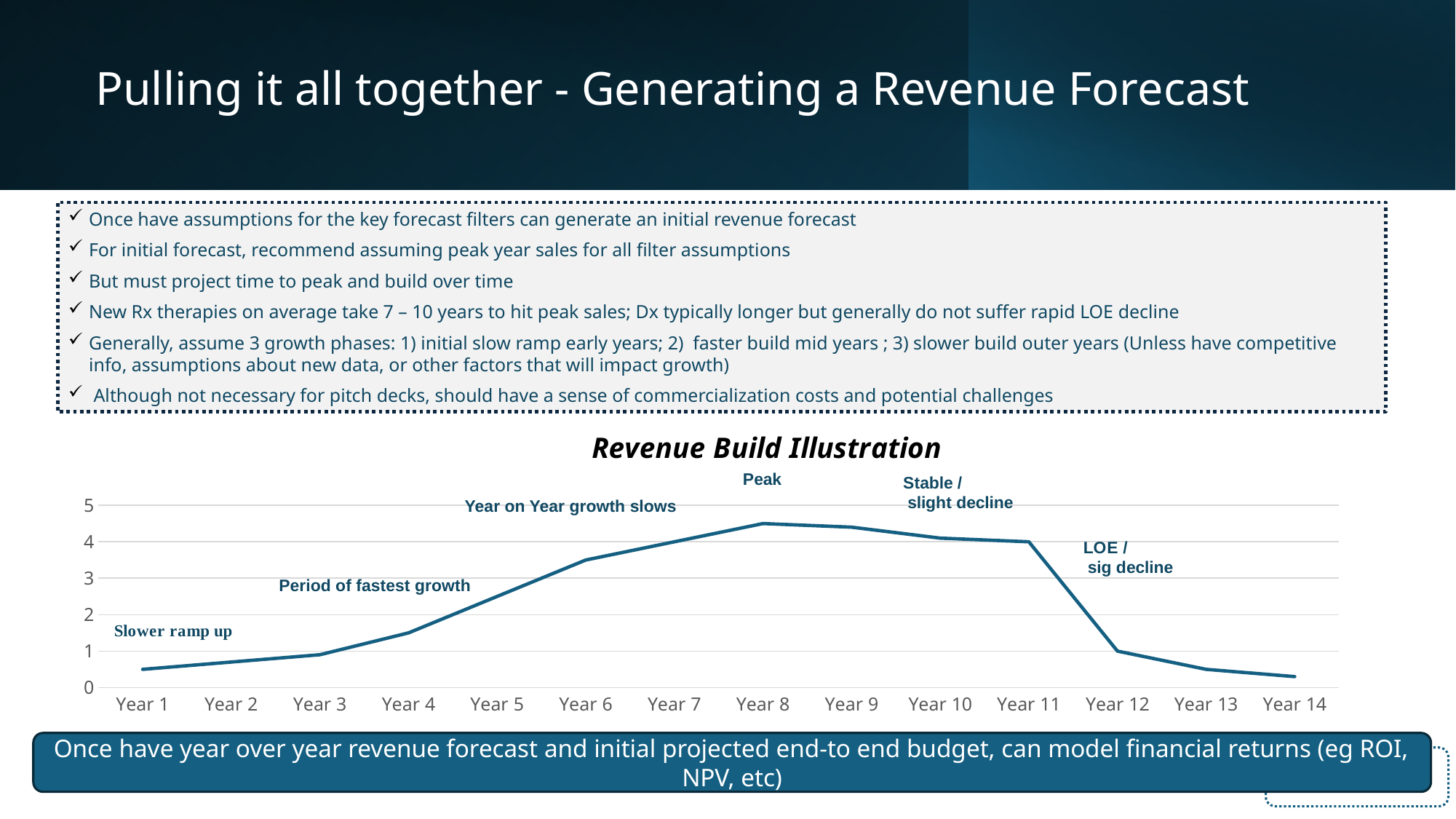
Which annotation label is placed above the line at Year 8? Peak Is the value for Year 12 greater or less than 2? less What kind of chart is shown on the slide? Line chart In which year does the line reach its lowest value? Year 14 Is the value for Year 6 greater or less than 3? greater Which is larger, the value for Year 8 or the value for Year 12? Year 8 Do the values rise or fall from Year 1 to Year 8? rise Is the value for Year 5 greater or less than 2? greater In which year does the line reach its highest value? Year 8 What is the title of the chart? Revenue Build Illustration How many years are plotted along the x axis of the chart? 14